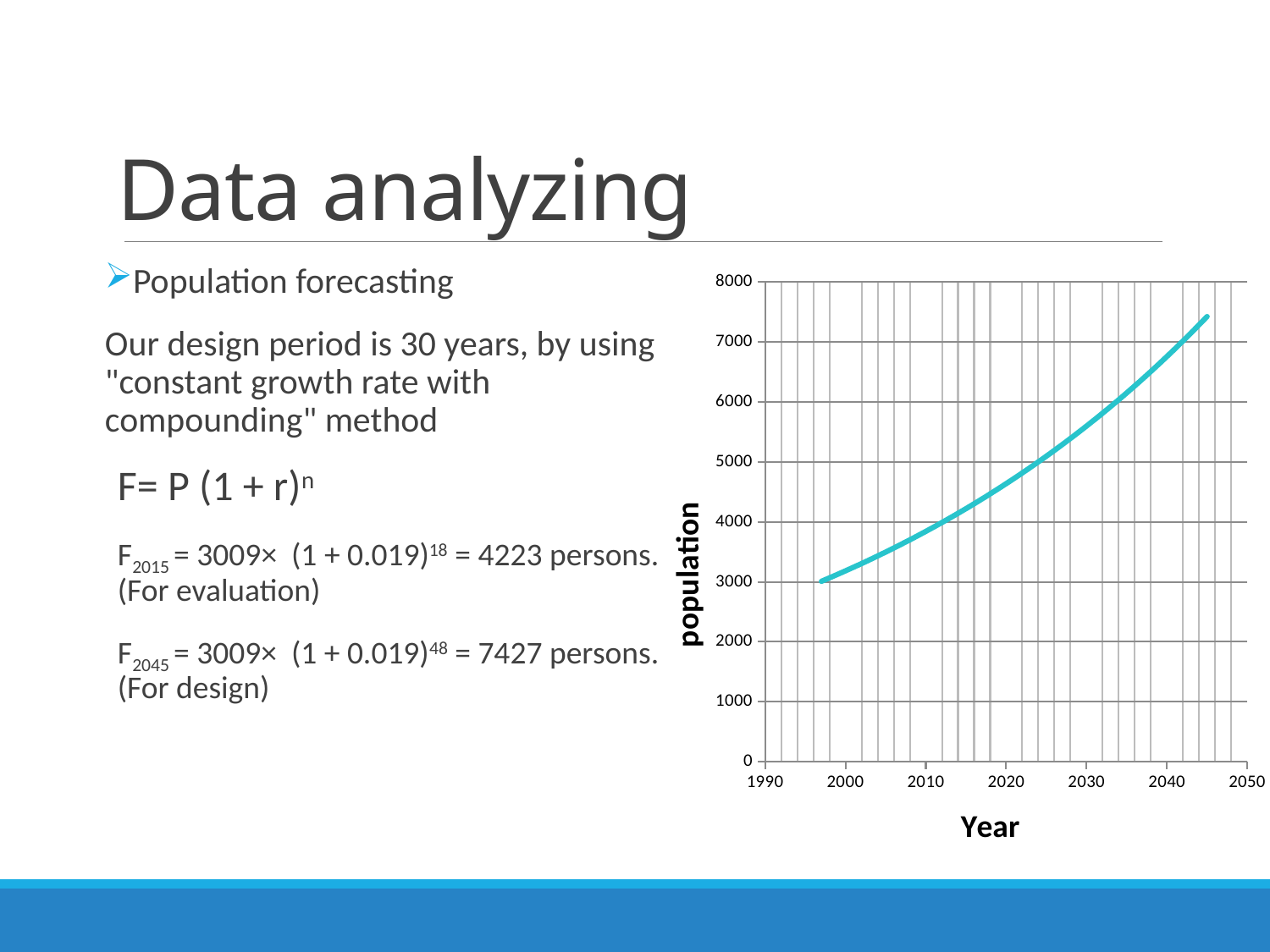
Is the population value at 2020 greater or less than 4000? greater Is the population value at 2000 greater or less than 4000? less Is the population value at 2020 greater or less than 5000? less What is the label of the vertical axis of the chart? population What is the label of the horizontal axis of the chart? Year What kind of chart is shown on the slide? line chart Does the population rise or fall as the year increases along the x axis? rise